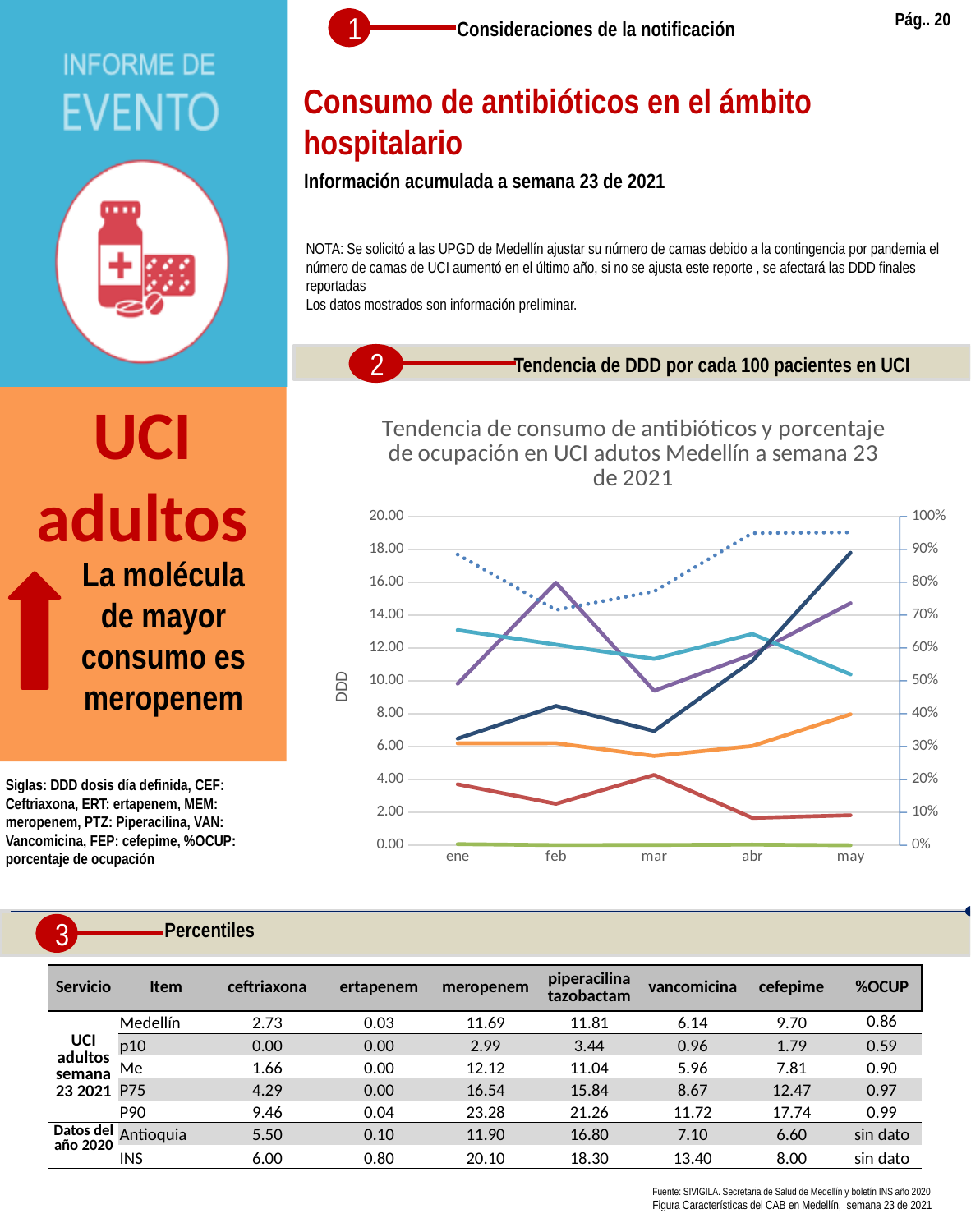
What is the maximum value shown on the left vertical axis of the line chart? 20.00 What is the title of the line chart? Tendencia de consumo de antibióticos y porcentaje de ocupación en UCI adutos Medellín a semana 23 de 2021 How many months are shown on the x axis of the line chart? 5 What is the first category on the x axis of the line chart? ene What is the label of the left vertical axis of the line chart? DDD What is the maximum value shown on the right vertical axis of the line chart? 100% How many lines are plotted in the line chart? 7 What kind of chart is shown under 'Tendencia de DDD por cada 100 pacientes en UCI'? line chart What is the last category on the x axis of the line chart? may